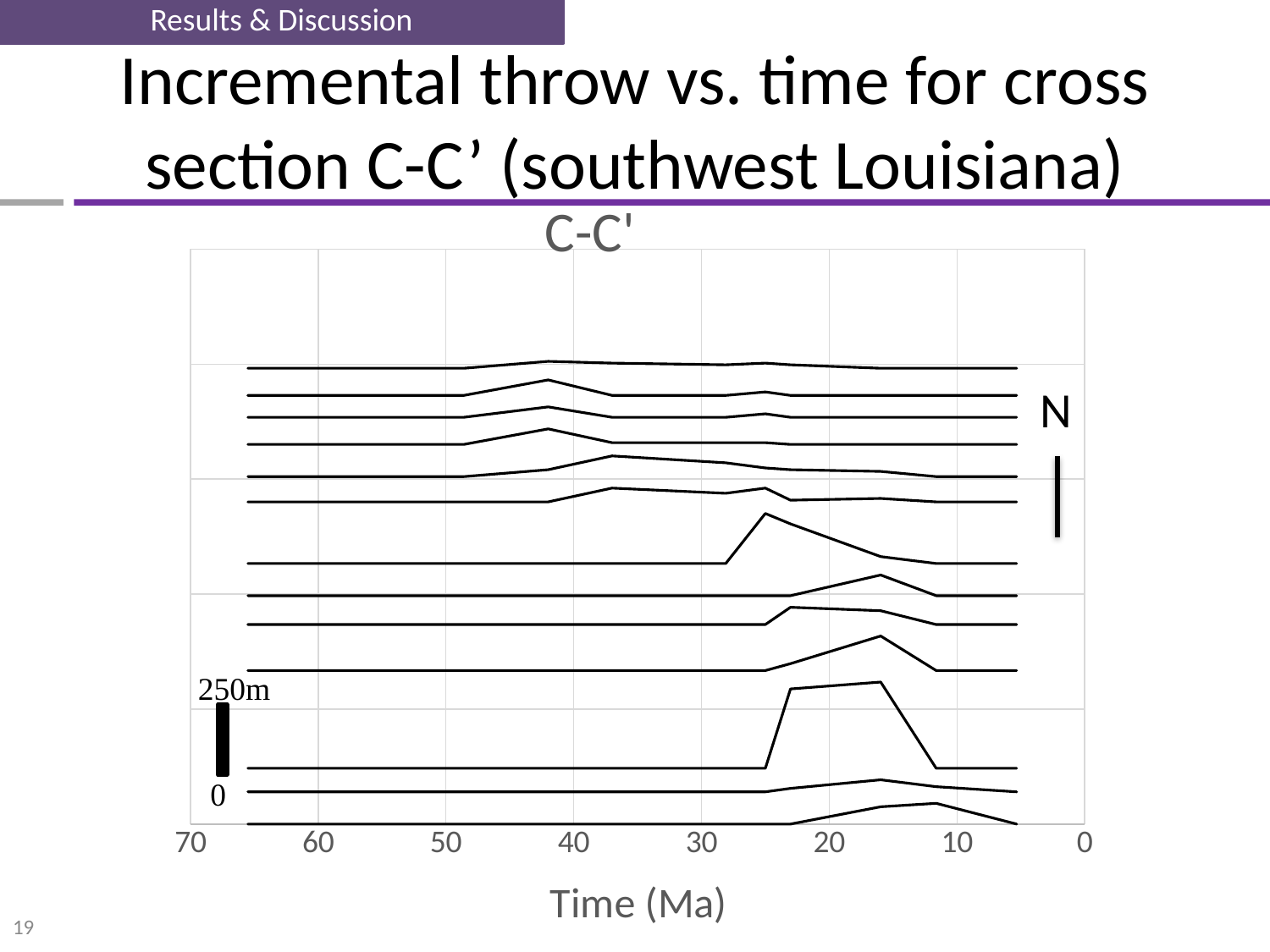
What kind of chart is shown on the slide? line chart What is the title of the chart? C-C' What length does the vertical scale bar at the lower left of the chart represent? 250m How many separate lines are plotted on the chart? 13 Does the tallest peak on the chart occur between 30 and 10 Ma or between 60 and 40 Ma? between 30 and 10 Ma Do the x-axis values increase or decrease from left to right? decrease How many tick labels are shown on the x axis? 8 What is the label of the x axis? Time (Ma) What is the rightmost tick value on the x axis? 0 What is the leftmost tick value on the x axis? 70